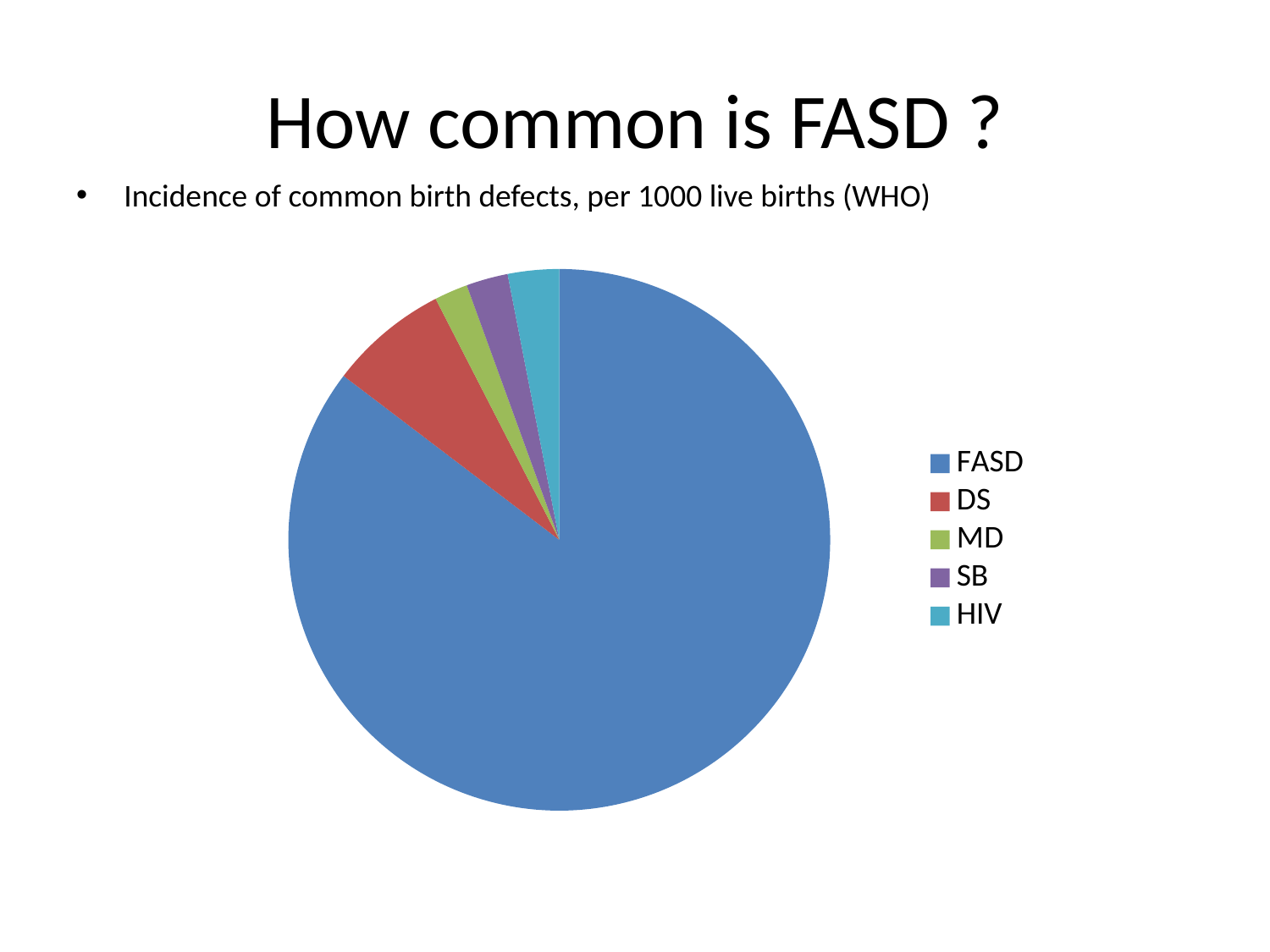
What colour is the FASD slice in the pie chart? blue Which category has the second-largest slice in the pie chart? DS Which category has the largest slice in the pie chart? FASD How many entries does the legend of the pie chart list? 5 Which slice is larger, DS or MD? DS How many slices does the pie chart have? 5 What kind of chart is shown on the slide? pie chart Which slice is larger, FASD or DS? FASD Which slice is larger, DS or HIV? DS Does the FASD slice take up more or less than half of the pie? more